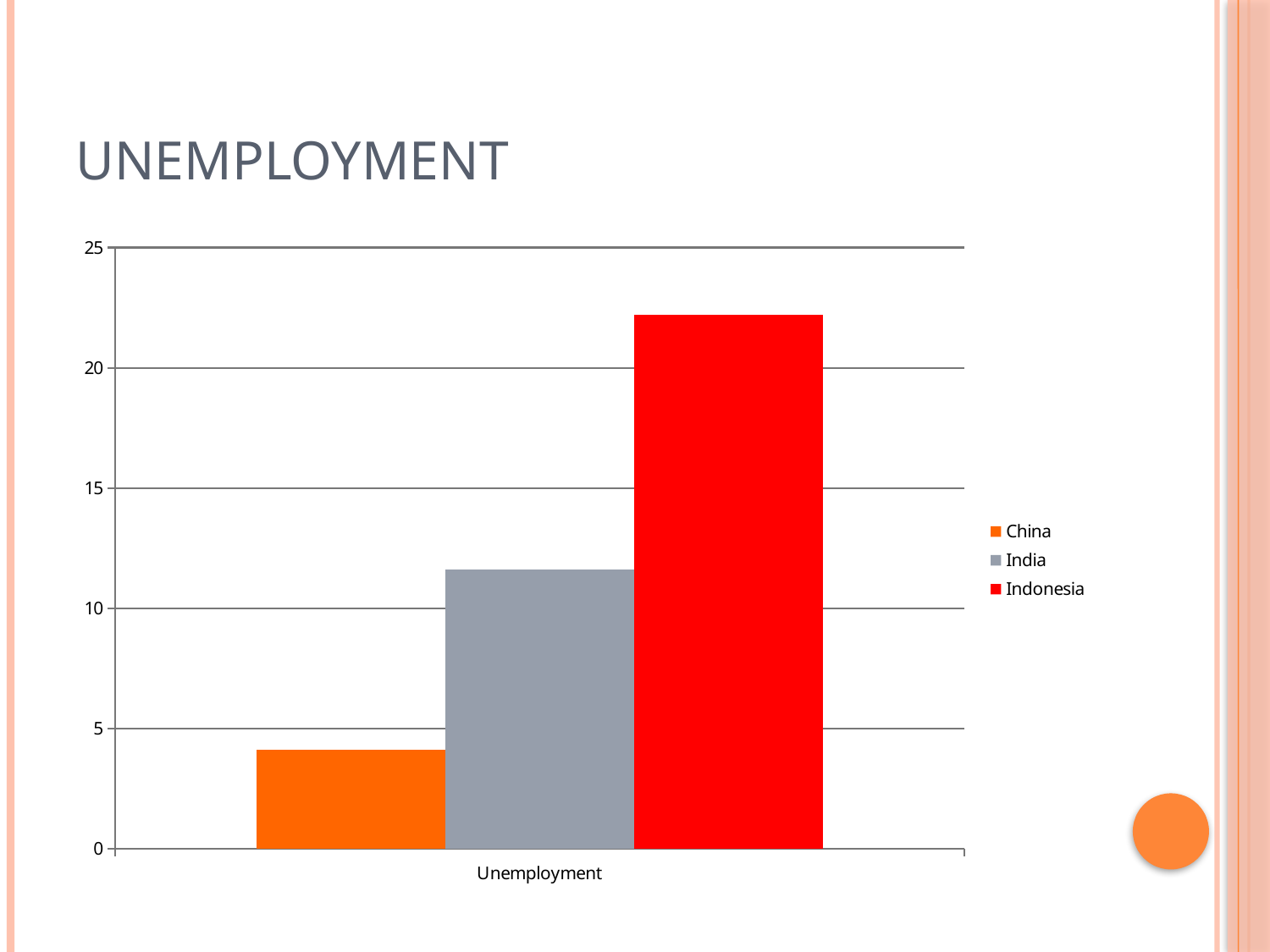
What is the title of the slide? UNEMPLOYMENT Which series has the lowest unemployment value? China How many series does the legend list? 3 Is the unemployment value for China greater or less than 5? less Is the unemployment value for India greater or less than 10? greater Which is larger, the unemployment value for India or for China? India Is the unemployment value for India greater or less than 15? less Which is larger, the unemployment value for Indonesia or for India? Indonesia What colour is the bar for Indonesia? red What kind of chart is shown on the slide? bar chart Which series has the highest unemployment value? Indonesia